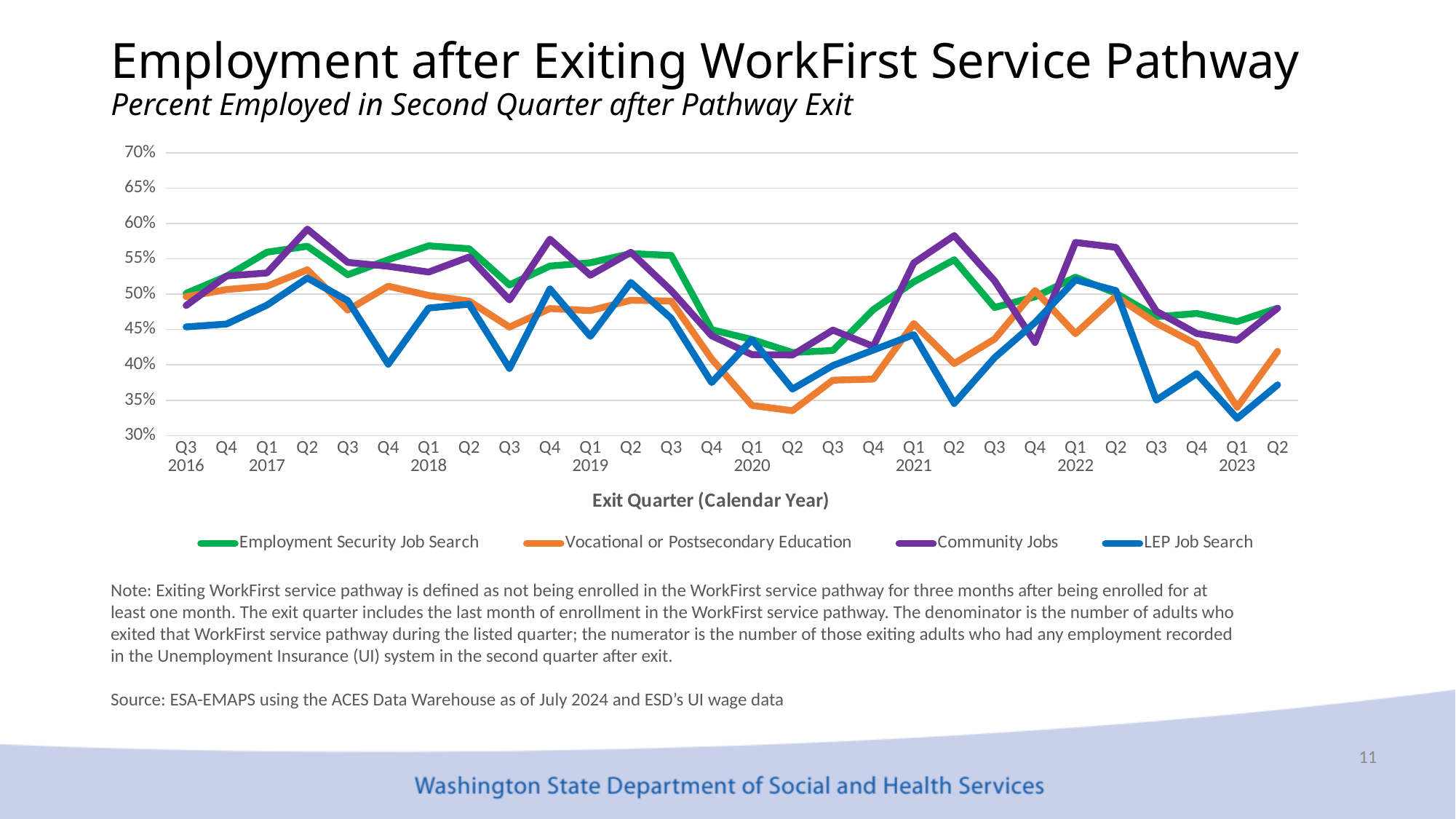
Is the value for Employment Security Job Search in Q1 2018 greater or less than 55%? greater How many exit quarters are plotted along the x axis? 28 Does the LEP Job Search line rise or fall from Q1 2022 to Q1 2023? Fall What is the title of the x axis? Exit Quarter (Calendar Year) How many series does the legend list? 4 In Q2 2017, which is larger: Community Jobs or LEP Job Search? Community Jobs Is the value for LEP Job Search in Q4 2017 greater or less than 45%? less Is the value for LEP Job Search in Q1 2023 greater or less than 35%? less What kind of chart is shown on the slide? Line chart In Q1 2020, which is larger: Employment Security Job Search or Vocational or Postsecondary Education? Employment Security Job Search